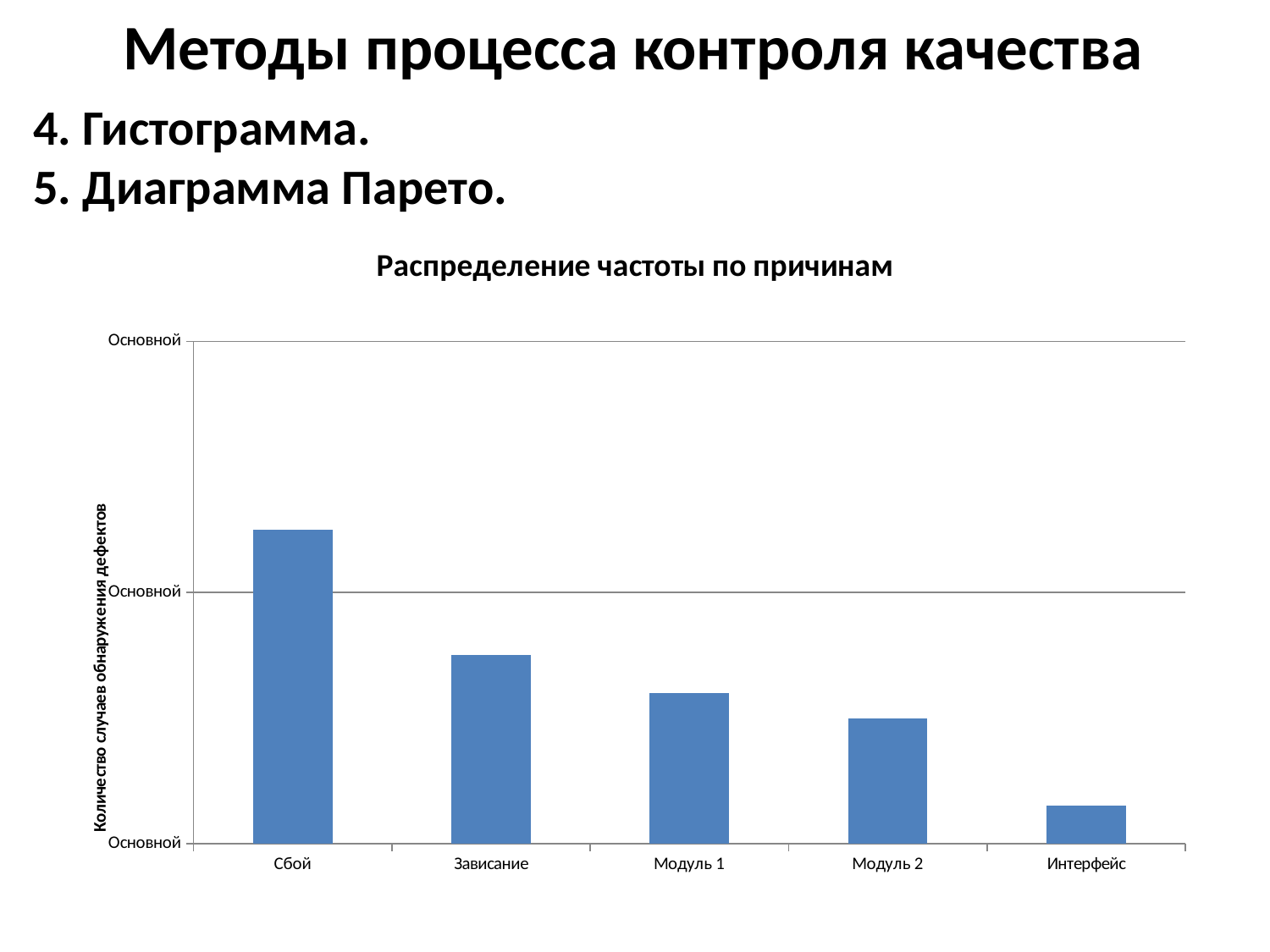
Which category has the lowest bar in the chart? Интерфейс How many categories are shown on the x axis of the chart? 5 Which bar is taller, Зависание or Интерфейс? Зависание What is the label of the vertical axis of the chart? Количество случаев обнаружения дефектов What is the title of the chart? Распределение частоты по причинам Which category is the second highest in the chart? Зависание Which bar is taller, Сбой or Зависание? Сбой Which category has the highest bar in the chart? Сбой Do the bar heights rise or fall from left to right along the x axis? Fall Which bar is taller, Модуль 1 or Модуль 2? Модуль 1 What kind of chart is shown on the slide? Bar chart